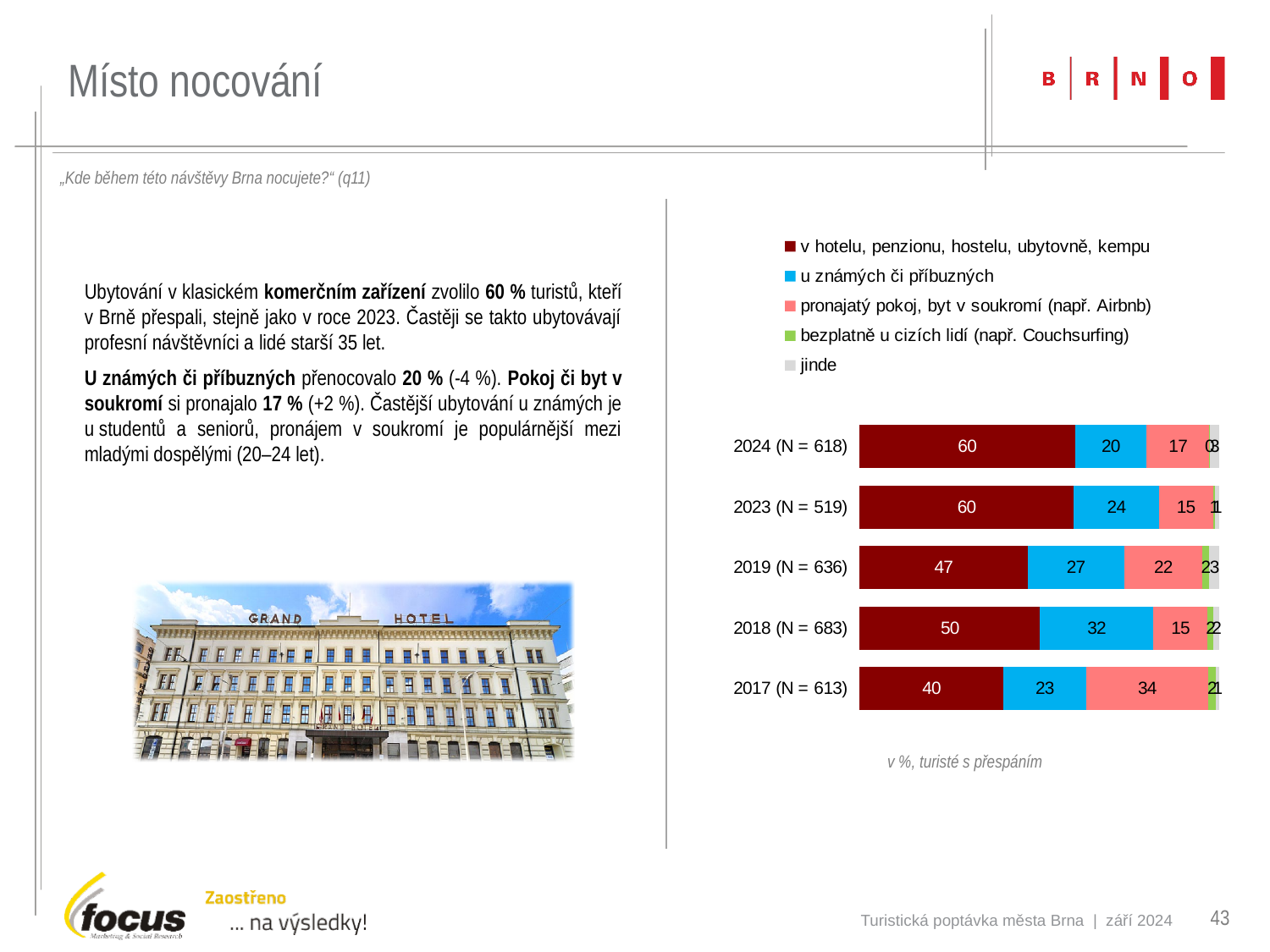
Which year has the larger value for "v hotelu, penzionu, hostelu, ubytovně, kempu": 2019 or 2018? 2018 (N = 683) How many years (bars) are shown in the chart? 5 Which year has the highest value for "u známých či příbuzných"? 2018 (N = 683) What is the value for "v hotelu, penzionu, hostelu, ubytovně, kempu" in 2024 (N = 618)? 60 What is the difference between the "u známých či příbuzných" values for 2023 and 2024? 4 What is the value for "u známých či příbuzných" in 2018 (N = 683)? 32 What is the difference between the "v hotelu, penzionu, hostelu, ubytovně, kempu" values for 2024 and 2017? 20 Which year has the lowest value for "v hotelu, penzionu, hostelu, ubytovně, kempu"? 2017 (N = 613) What kind of chart is shown on the slide? Stacked bar chart How many series does the legend list? 5 What is the value for "pronajatý pokoj, byt v soukromí (např. Airbnb)" in 2019 (N = 636)? 22 What is the value for "pronajatý pokoj, byt v soukromí (např. Airbnb)" in 2017 (N = 613)? 34